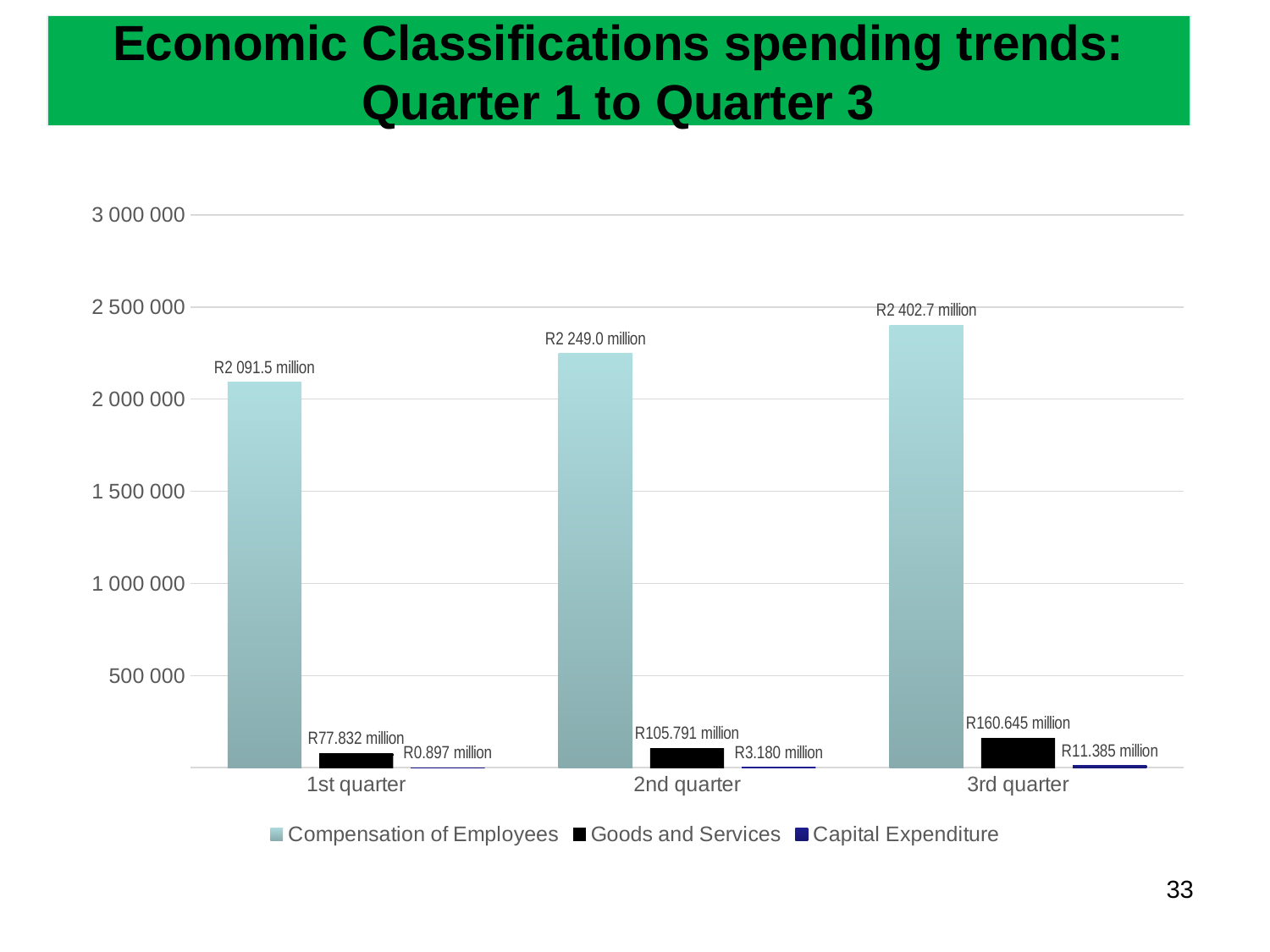
How many series does the legend list? 3 What kind of chart is shown on the slide? Bar chart How many quarters are shown on the x axis? 3 What is the value for Capital Expenditure in the 1st quarter? R0.897 million Which is larger: Goods and Services in the 3rd quarter or Goods and Services in the 2nd quarter? Goods and Services in the 3rd quarter Do the Capital Expenditure values rise or fall from the 1st quarter to the 3rd quarter? Rise What is the value for Capital Expenditure in the 3rd quarter? R11.385 million In which quarter is Goods and Services lowest? 1st quarter What is the value for Goods and Services in the 2nd quarter? R105.791 million What is the value for Compensation of Employees in the 1st quarter? R2 091.5 million In which quarter is Compensation of Employees highest? 3rd quarter What is the difference between Compensation of Employees in the 3rd quarter and in the 1st quarter? R311.2 million